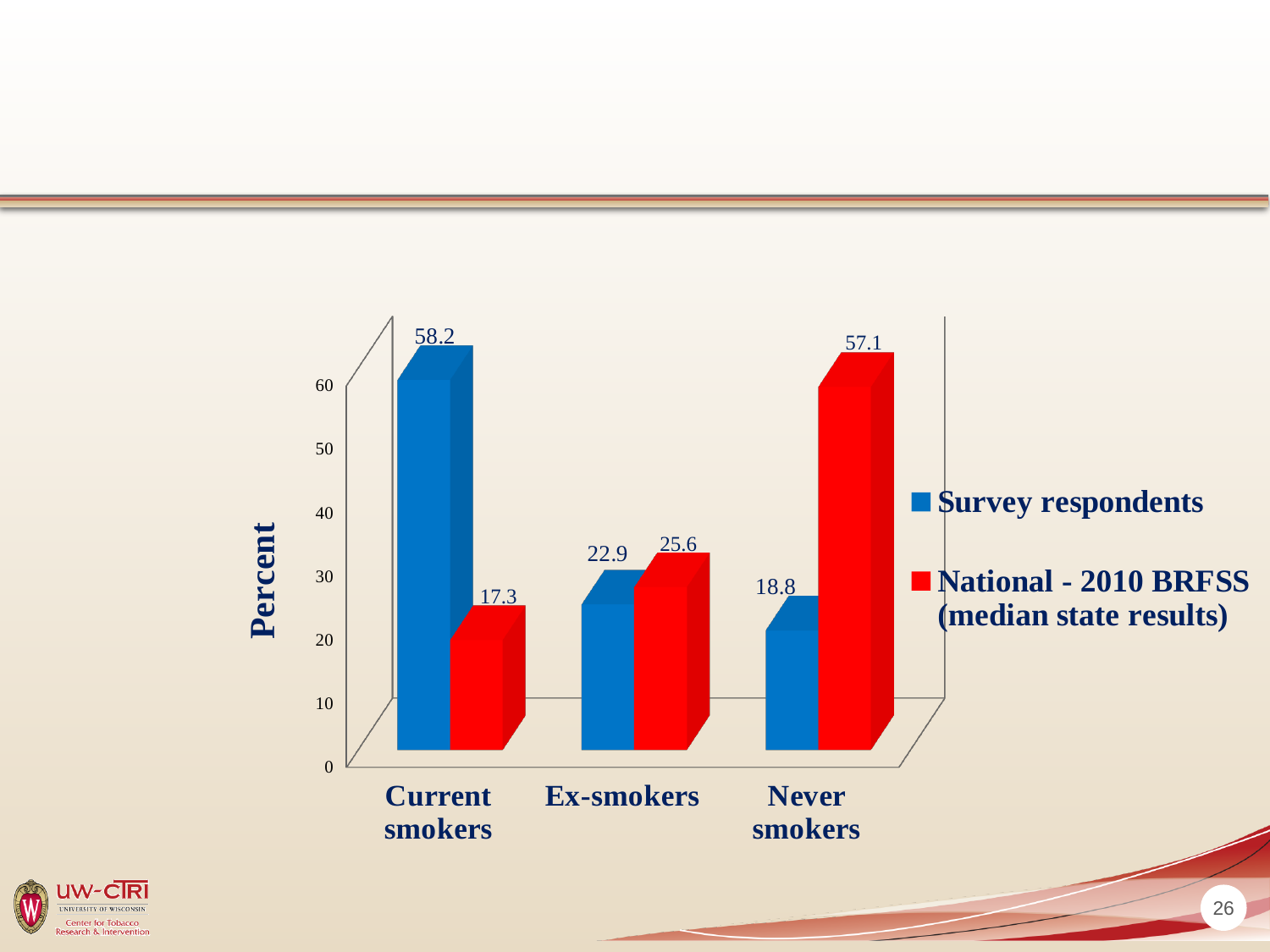
What is the value for Survey respondents among Ex-smokers? 22.9 What is the difference between the Survey respondents and National - 2010 BRFSS values for Current smokers? 40.9 What is the value for National - 2010 BRFSS (median state results) among Never smokers? 57.1 How many categories are shown on the x axis? 3 What is the value for Survey respondents among Current smokers? 58.2 What is the value for National - 2010 BRFSS (median state results) among Current smokers? 17.3 What is the label on the vertical axis? Percent How many series does the legend list? 2 What kind of chart is shown on the slide? Bar chart Which category has the highest value for Survey respondents? Current smokers For Ex-smokers, which series has the larger value: Survey respondents or National - 2010 BRFSS (median state results)? National - 2010 BRFSS (median state results) Which category has the lowest value for National - 2010 BRFSS (median state results)? Current smokers